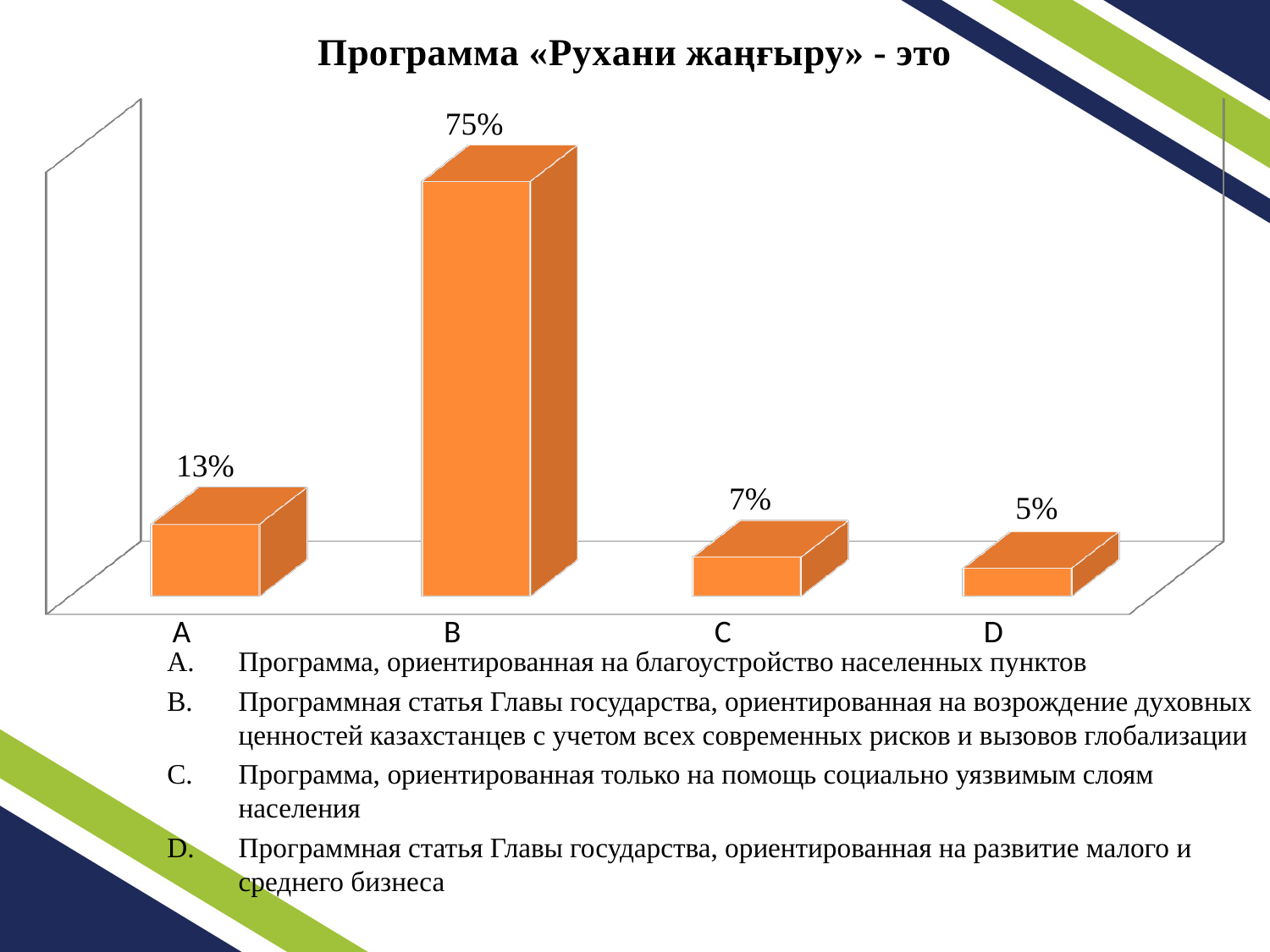
What is the value for category D? 5% What is the difference between the values for C and D? 2% What is the difference between the values for B and A? 62% What is the title of the chart? Программа «Рухани жаңғыру» - это How many categories are shown on the chart? 4 What kind of chart is shown on the slide? bar chart Which category has the highest value? B What is the value for category C? 7% What is the value for category B? 75% Which category has the lowest value? D What is the value for category A? 13% Which is larger, the value for A or the value for C? A